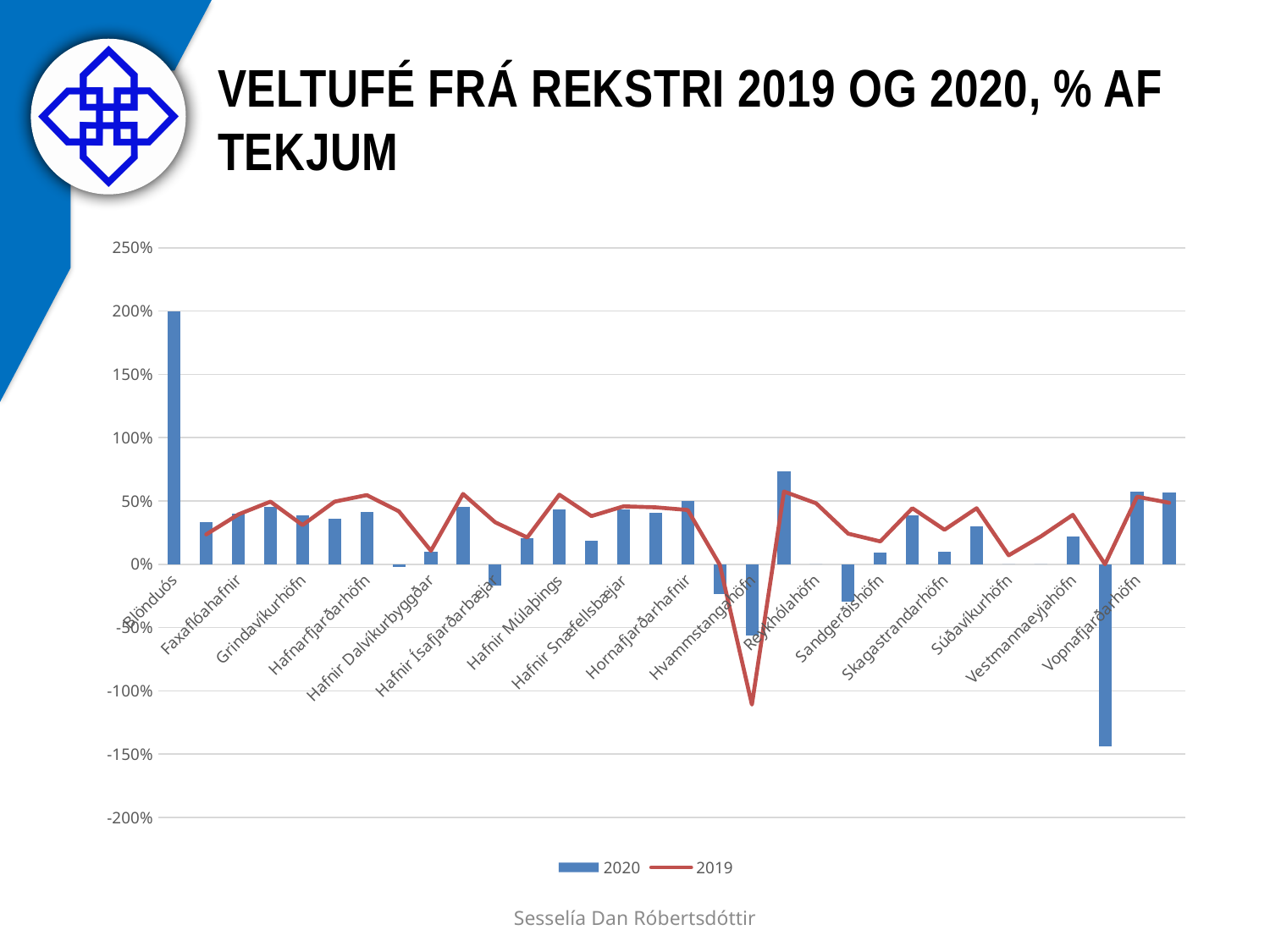
Which has the larger 2020 value, Blönduós or Reykhólahöfn? Blönduós Which has the larger 2020 value, Reykhólahöfn or Hafnarfjarðarhöfn? Hafnarfjarðarhöfn What is the title of the chart? VELTUFÉ FRÁ REKSTRI 2019 OG 2020, % AF TEKJUM How many series does the legend list? 2 Is the 2020 value for Faxaflóahafnir greater or less than 50%? less Which category has the highest 2020 value? Blönduós Is the 2020 value for Vopnafjarðarhöfn greater or less than -100%? greater Which series is drawn as a line rather than bars? 2019 Is the 2020 value for Blönduós greater or less than 150%? greater What kind of chart is shown on the slide? bar chart with a line